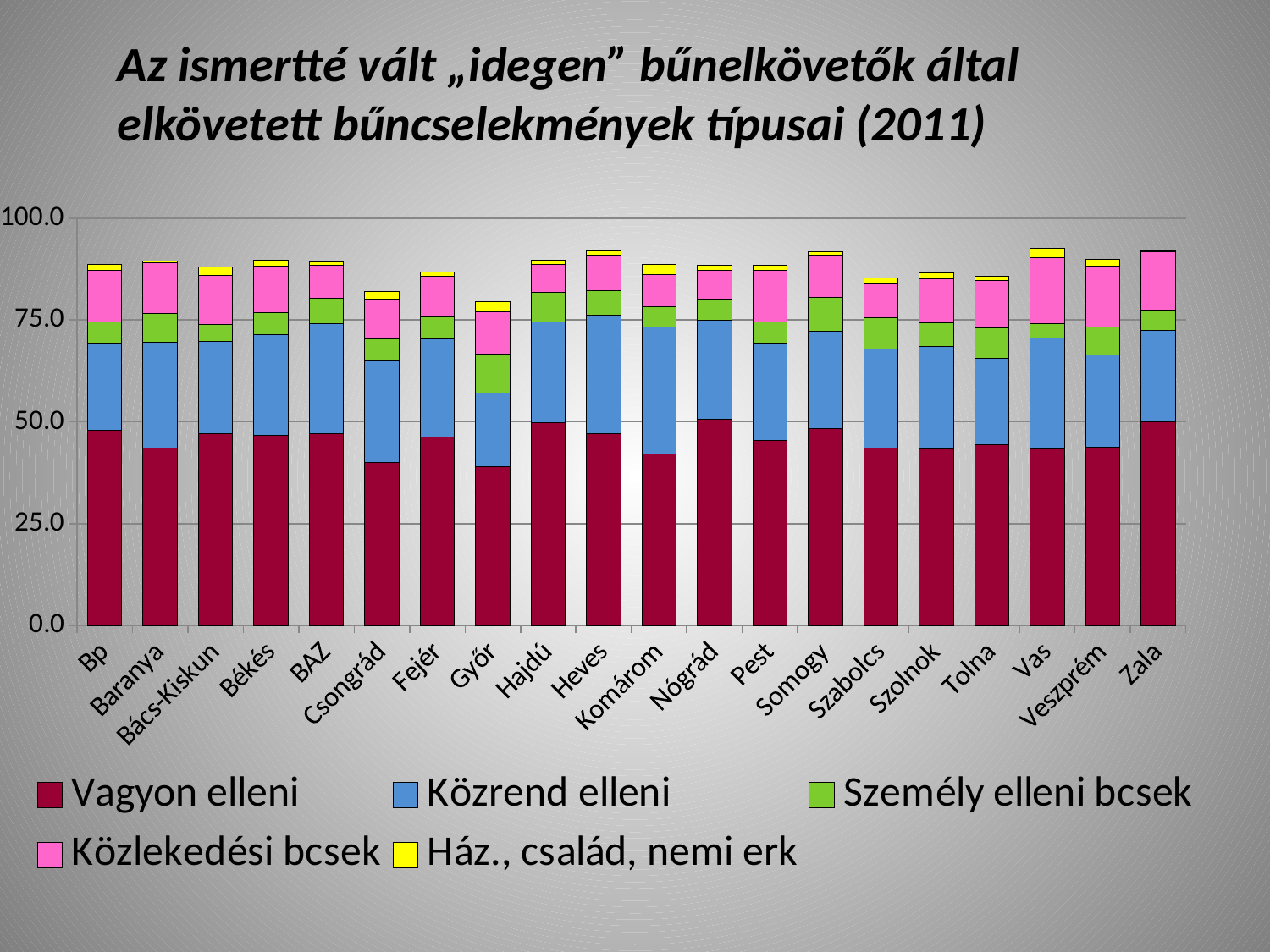
Which has the larger "Vagyon elleni" value, Bp or Győr? Bp Which series is plotted at the bottom of each stacked bar? Vagyon elleni Is the "Vagyon elleni" value for Komárom greater or less than 50? less Which has the taller total stacked bar, Vas or Győr? Vas What kind of chart is shown on the slide? Stacked bar chart Is the "Vagyon elleni" value for Csongrád greater or less than 50? less What colour represents the "Ház., család, nemi erk" series? Yellow Is the total height of the stacked bar for Csongrád greater or less than 75? greater How many series does the legend list? 5 How many counties/categories are shown along the x axis? 20